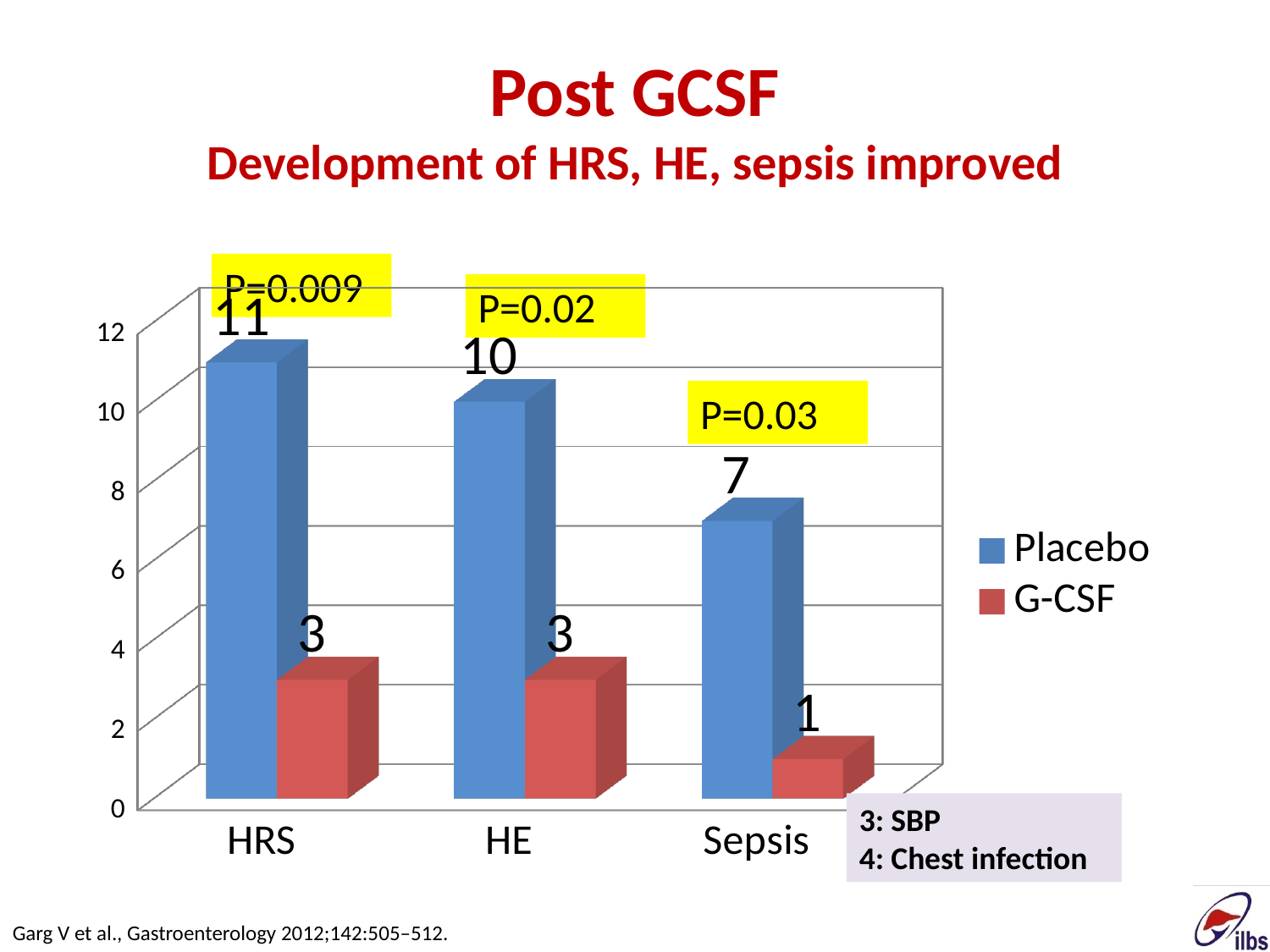
What is the difference between the Placebo and G-CSF values for HE? 7 Which category has the highest Placebo value? HRS What kind of chart is shown on the slide? bar chart How many categories are shown on the x axis? 3 What P value is shown above the HE bars? P=0.02 For Sepsis, which is larger: the Placebo value or the G-CSF value? Placebo Do the Placebo values rise or fall from HRS to Sepsis? fall What is the Placebo value for HRS? 11 How many series does the legend list? 2 Which category has the lowest G-CSF value? Sepsis What is the Placebo value for HE? 10 What is the G-CSF value for Sepsis? 1